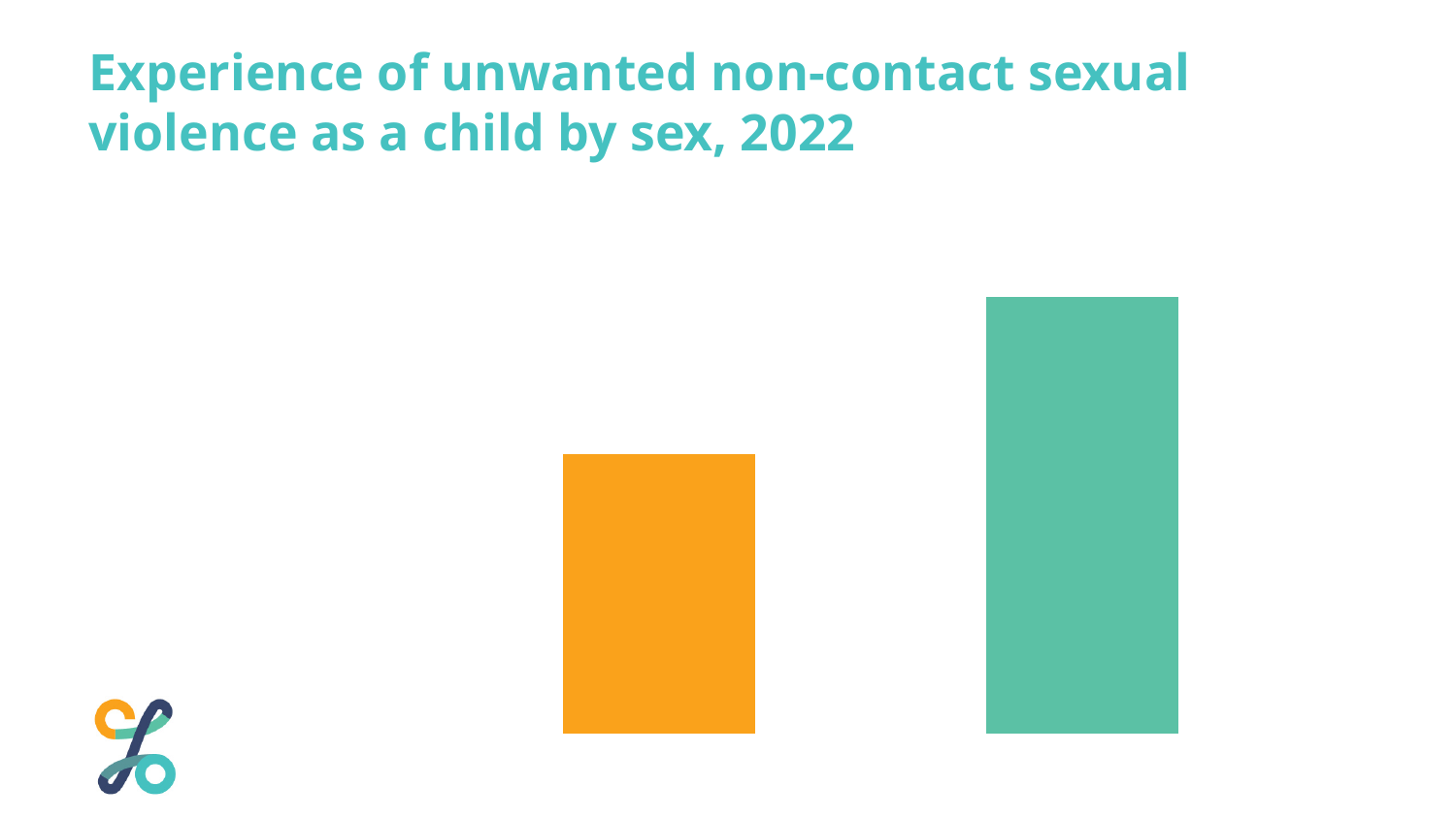
How many bars does the chart show? 2 Which bar is taller, the left (orange) bar or the right (green) bar? the right (green) bar What is the title of the chart on the slide? Experience of unwanted non-contact sexual violence as a child by sex, 2022 Do the bar heights rise or fall from left to right? rise What colour is the left bar on the chart? orange What kind of chart is shown on the slide? bar chart Which bar is the tallest on the chart? the right (green) bar Which bar is the shortest on the chart? the left (orange) bar